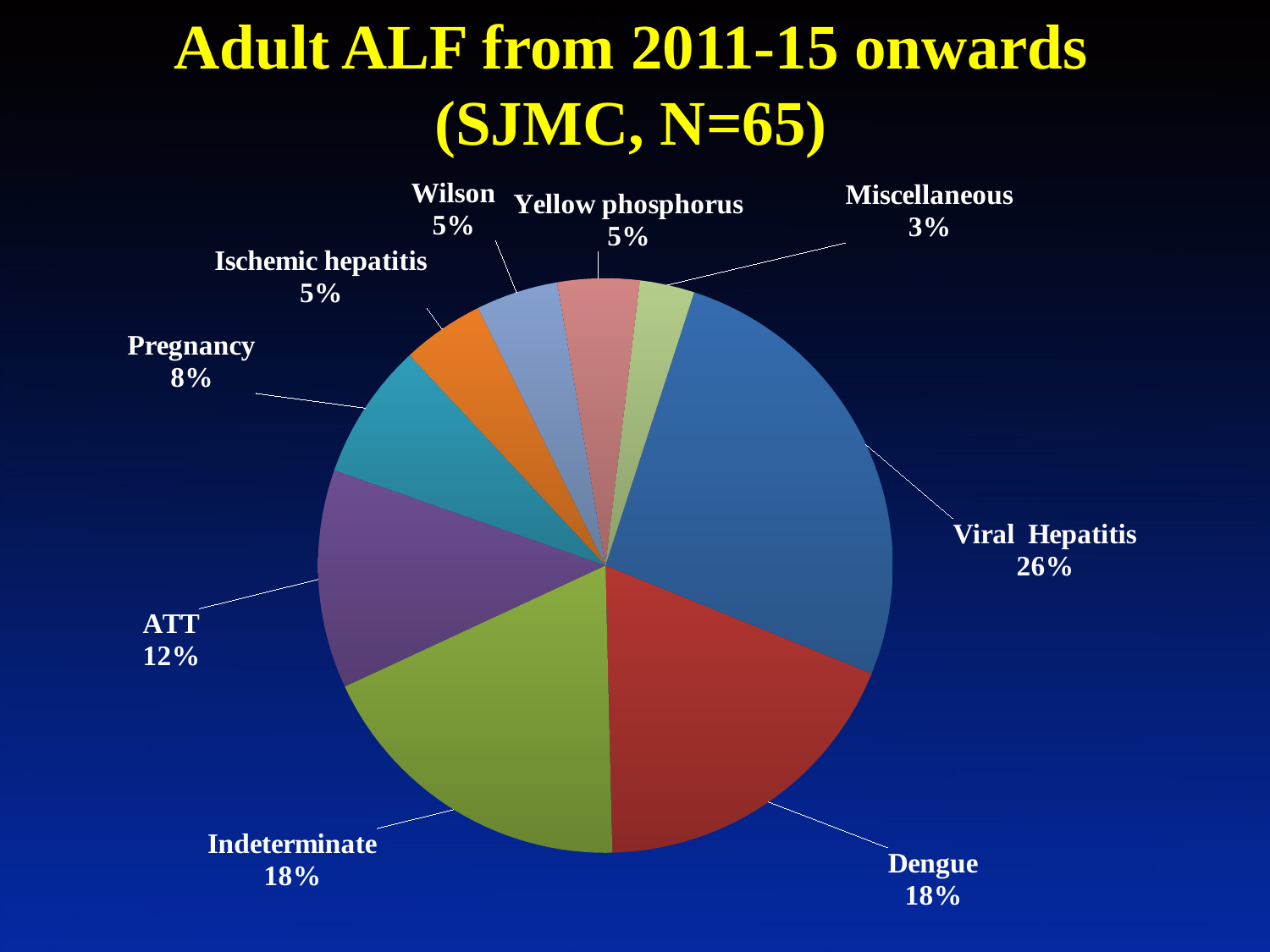
What is the difference between the Viral Hepatitis share and the Dengue share? 8% What is the value shown for Pregnancy? 8% What is the combined share of Indeterminate and Dengue? 36% Which is larger, the share for ATT or the share for Pregnancy? ATT Which category has the smallest slice of the pie? Miscellaneous Which category has the largest slice of the pie? Viral Hepatitis What is the value shown for ATT? 12% What is the value shown for Yellow phosphorus? 5% What kind of chart is shown on the slide? pie chart How many categories are shown in the pie chart? 9 What share of the pie does Viral Hepatitis account for? 26% What is the title of the chart? Adult ALF from 2011-15 onwards (SJMC, N=65)